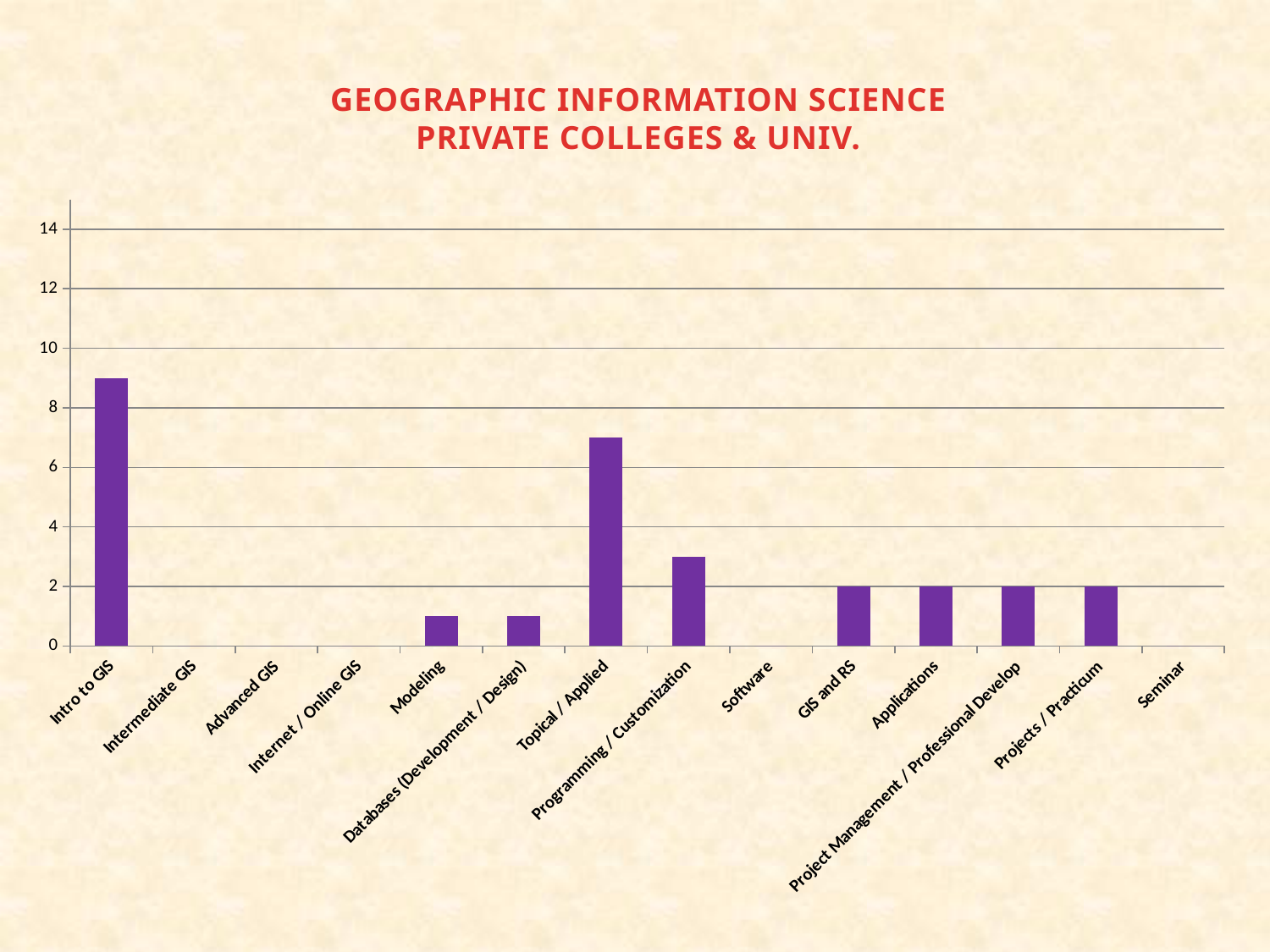
What kind of chart is shown on the slide? bar chart What is the difference between the value for Applications and the value for Software? 2 Is the value for Intro to GIS greater or less than 8? greater Is the value for Topical / Applied greater or less than 8? less Which is larger, the value for Intro to GIS or the value for Topical / Applied? Intro to GIS Is the value for Programming / Customization greater or less than 4? less What is the value for Seminar? 0 What is the title of the chart? GEOGRAPHIC INFORMATION SCIENCE PRIVATE COLLEGES & UNIV. What is the value for Projects / Practicum? 2 How many categories are shown on the x axis? 14 What is the value for GIS and RS? 2 Which category has the highest value? Intro to GIS